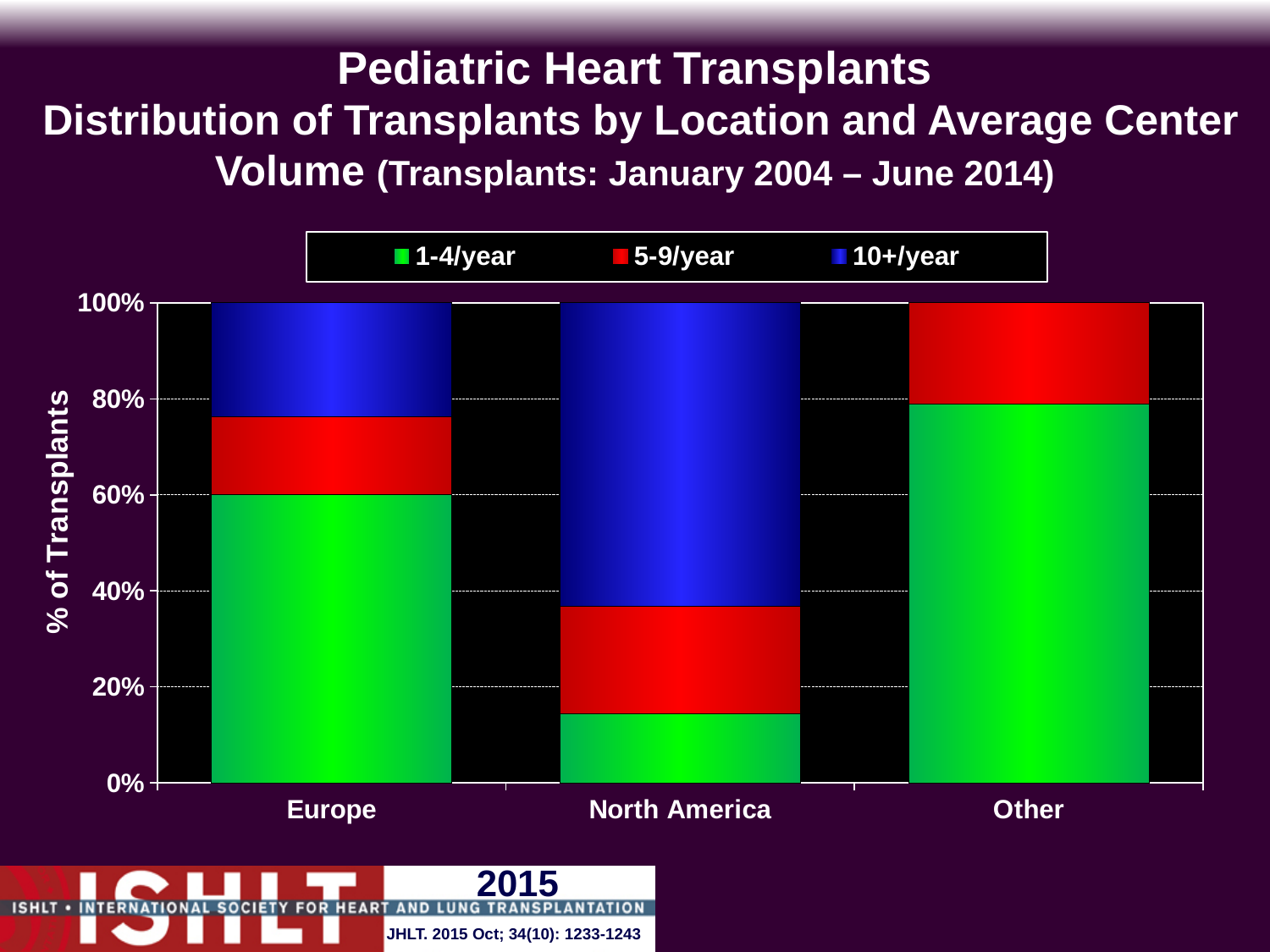
Is the 1-4/year share for Other greater or less than 60%? greater Which location has the smallest share of transplants in the 1-4/year category? North America How many locations are shown on the x axis of the chart? 3 Which has a larger 10+/year share, Europe or North America? North America Is the 1-4/year share for North America greater or less than 20%? less What kind of chart is shown on the slide? Stacked bar chart Which location has the largest share of transplants in the 10+/year category? North America What is the total height of the stacked bar for Europe? 100% Is the 10+/year share for North America greater or less than 40%? greater How many series does the legend list? 3 What is the label of the y axis? % of Transplants